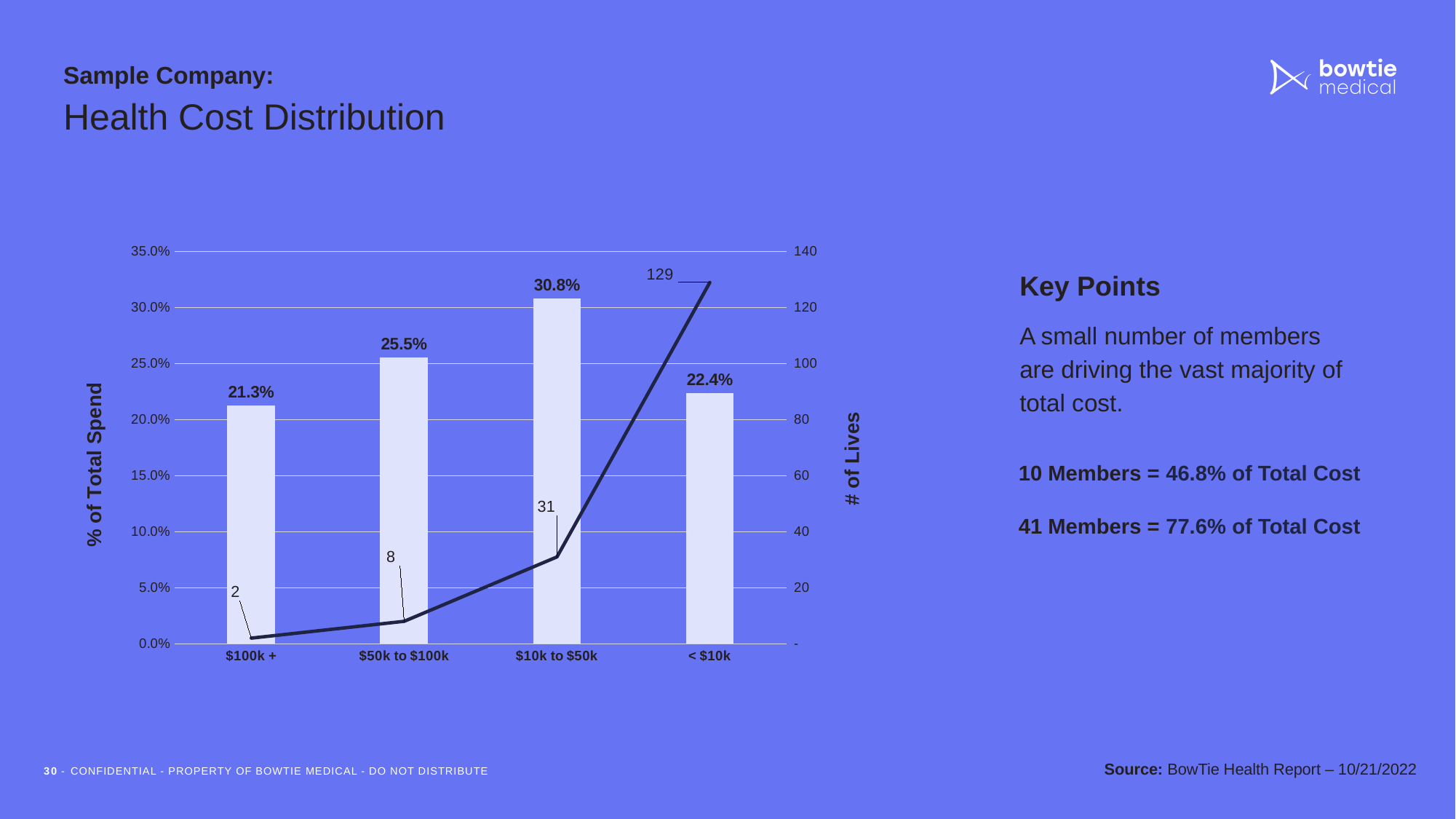
What is the difference in # of Lives between the < $10k and $10k to $50k categories? 98 Does the # of Lives line rise or fall from left to right across the x axis? rise What is the % of Total Spend for the $100k + category? 21.3% Which category has the highest % of Total Spend? $10k to $50k How many lives are in the < $10k category? 129 How many cost categories are shown on the x axis? 4 How many lives are in the $50k to $100k category? 8 What is the label of the right-hand vertical axis? # of Lives Which category has the lowest number of lives? $100k + What is the difference in % of Total Spend between $10k to $50k and $100k +? 9.5% Which has a higher % of Total Spend, $50k to $100k or < $10k? $50k to $100k What is the % of Total Spend for the $10k to $50k category? 30.8%